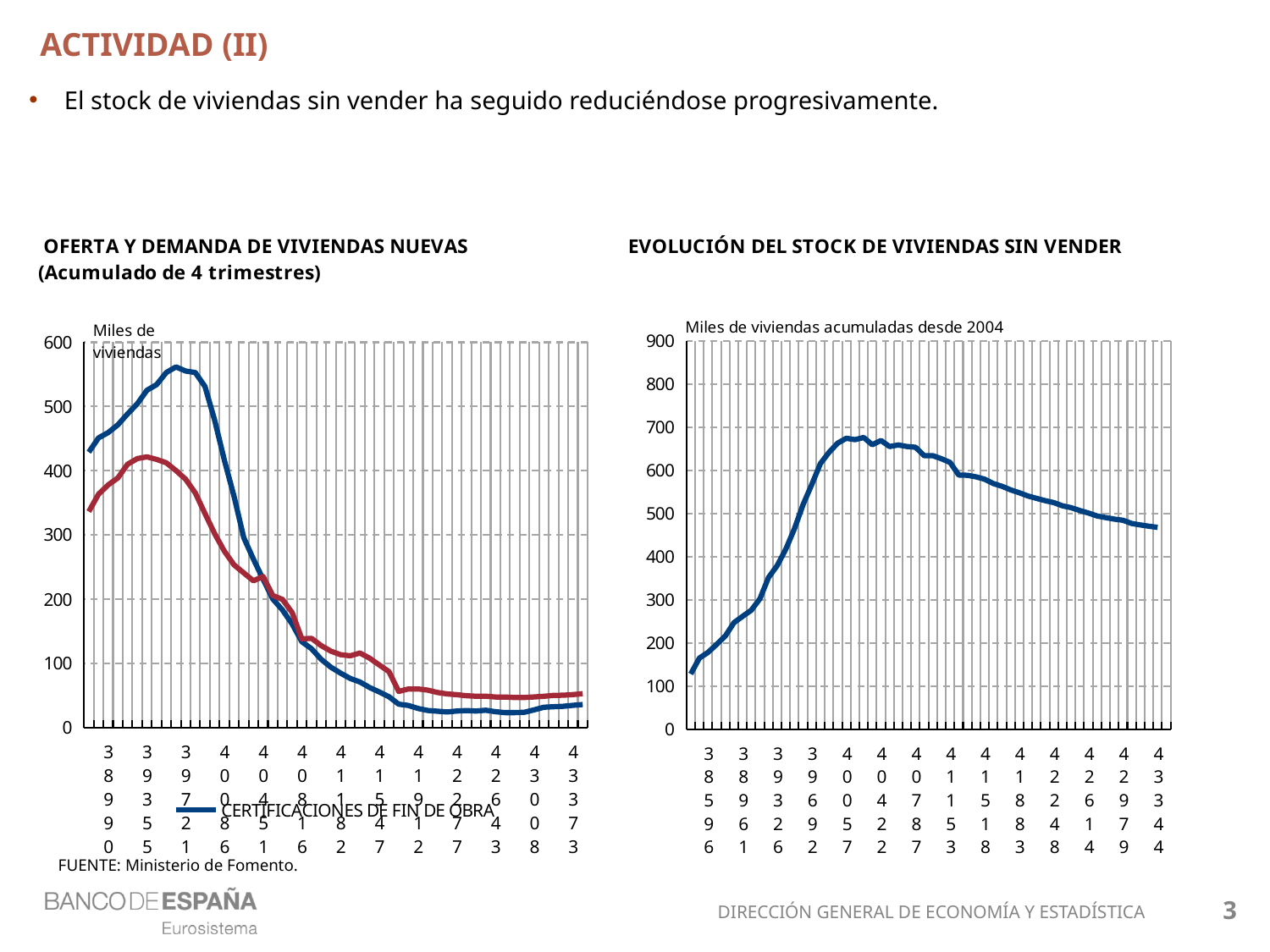
In the right chart, is the peak value of the line greater or less than 700? less In the right chart, is the last value of the line greater or less than 500? less In the left chart, which line reaches a higher peak, the blue line or the red line? the blue line How many lines are plotted in the right chart, 'EVOLUCIÓN DEL STOCK DE VIVIENDAS SIN VENDER'? 1 What kind of chart is the left chart, 'OFERTA Y DEMANDA DE VIVIENDAS NUEVAS'? line chart What is the unit label shown at the top of the right chart's y axis? Miles de viviendas acumuladas desde 2004 In the left chart, does the blue line 'CERTIFICACIONES DE FIN DE OBRA' rise or fall from its peak to the end of the series? fall In the right chart, is the peak value of the line greater or less than 600? greater What kind of chart is the right chart, 'EVOLUCIÓN DEL STOCK DE VIVIENDAS SIN VENDER'? line chart In the right chart, 'EVOLUCIÓN DEL STOCK DE VIVIENDAS SIN VENDER', does the line rise or fall over the last part of the series? fall